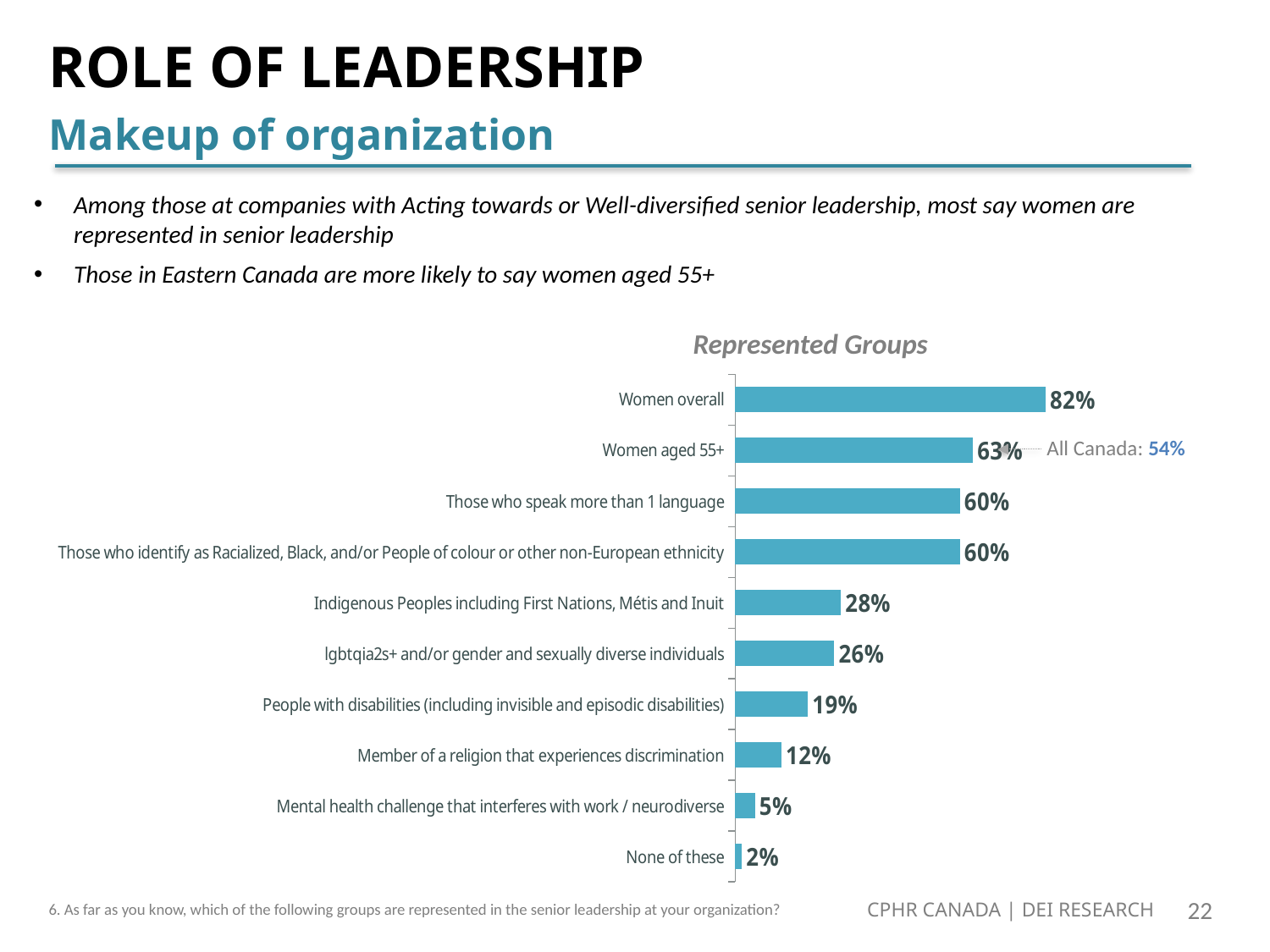
Which is larger: the value for Indigenous Peoples including First Nations, Métis and Inuit or the value for lgbtqia2s+ and/or gender and sexually diverse individuals? Indigenous Peoples including First Nations, Métis and Inuit Which category has the lowest value in the Represented Groups chart? None of these What percentage is shown for People with disabilities (including invisible and episodic disabilities)? 19% What is the title of the chart on the slide? Represented Groups What kind of chart is the Represented Groups chart? Bar chart What is the difference between the values for Women overall and Women aged 55+? 19% What value is shown for Indigenous Peoples including First Nations, Métis and Inuit? 28% Which group has the highest value in the Represented Groups chart? Women overall What percentage is shown for Women overall in the Represented Groups chart? 82% How many categories are plotted in the Represented Groups chart? 10 What is the difference between the values for Member of a religion that experiences discrimination and Mental health challenge that interferes with work / neurodiverse? 7% What is the All Canada value annotated next to the Women aged 55+ bar? 54%